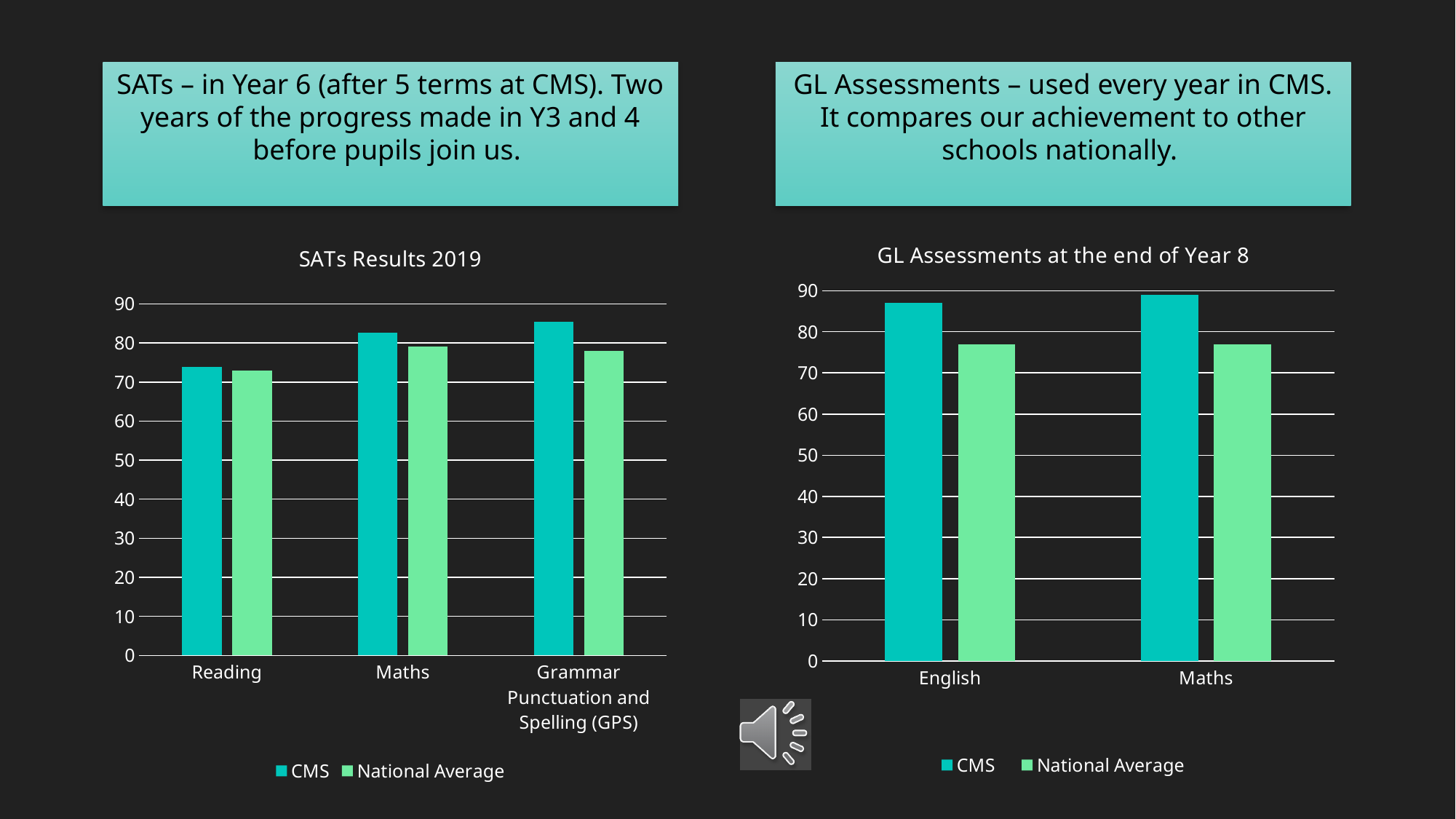
In the SATs Results 2019 chart, what kind of chart is shown? bar chart In the SATs Results 2019 chart, which category has the highest CMS value? Grammar Punctuation and Spelling (GPS) In the SATs Results 2019 chart, which category has the lowest CMS value? Reading In the GL Assessments at the end of Year 8 chart, is the National Average value for Maths greater or less than 80? less In the GL Assessments at the end of Year 8 chart, for English, which is larger: CMS or National Average? CMS In the SATs Results 2019 chart, how many series does the legend list? 2 In the GL Assessments at the end of Year 8 chart, how many categories are shown on the x axis? 2 In the SATs Results 2019 chart, is the CMS value for Grammar Punctuation and Spelling (GPS) greater or less than 80? greater In the SATs Results 2019 chart, for Grammar Punctuation and Spelling (GPS), which is larger: CMS or National Average? CMS In the SATs Results 2019 chart, how many categories are shown on the x axis? 3 In the GL Assessments at the end of Year 8 chart, is the CMS value for English greater or less than 80? greater